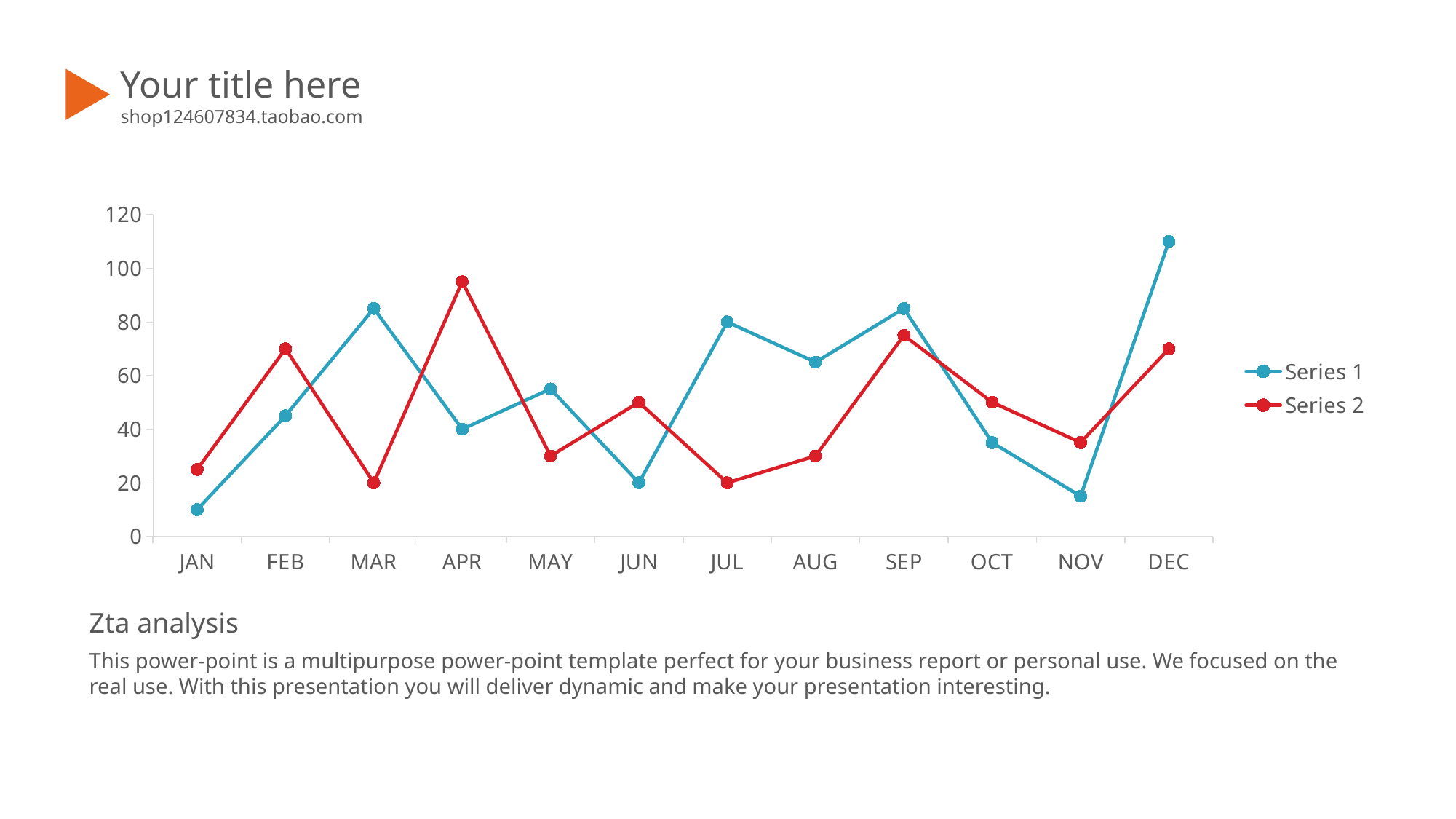
What kind of chart is shown on the slide? line chart In which month does Series 2 reach its highest value? APR How many series does the legend list? 2 In JAN, which series has the larger value, Series 1 or Series 2? Series 2 What is the value of Series 2 in MAR? 20 Is the value for Series 1 in NOV greater or less than 20? less Is the value for Series 1 in DEC greater or less than 100? greater How many months are plotted along the x axis? 12 Which colour is used for the Series 2 line? red What is the value of Series 1 in JUN? 20 In which month does Series 1 reach its highest value? DEC What is the value of Series 1 in JUL? 80